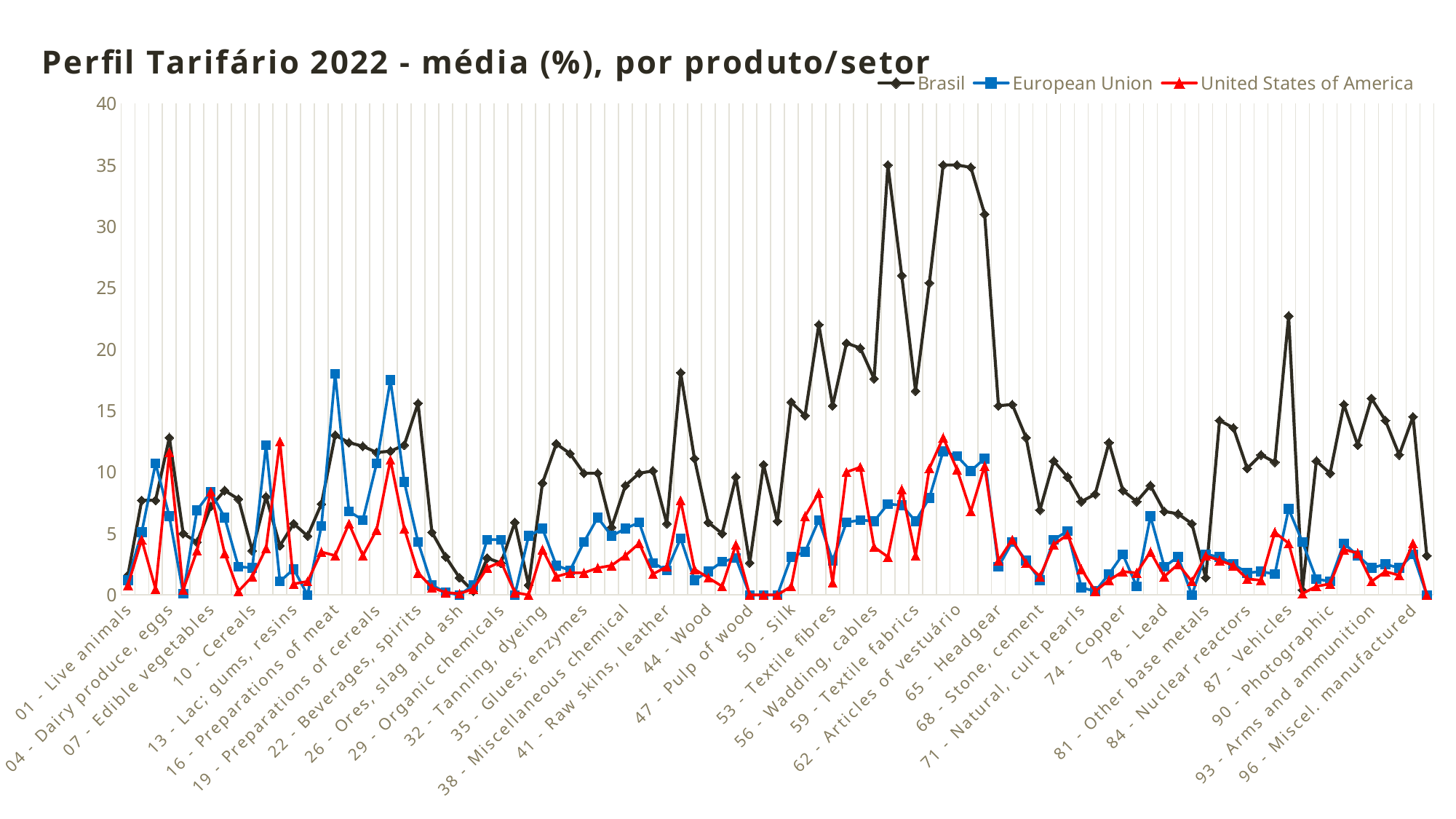
Is the Brasil value for 87 - Vehicles greater or less than 20? greater At 62 - Articles of vestuário, which series has the larger value, Brasil or European Union? Brasil How many series does the legend list? 3 Is the Brasil value for 62 - Articles of vestuário greater or less than 30? greater Is the United States of America value for 01 - Live animals greater or less than 5? less What kind of chart is shown on the slide? Line chart Which series reaches the highest value anywhere on the chart? Brasil Which series is drawn in red? United States of America What is the title of the chart? Perfil Tarifário 2022 - média (%), por produto/setor